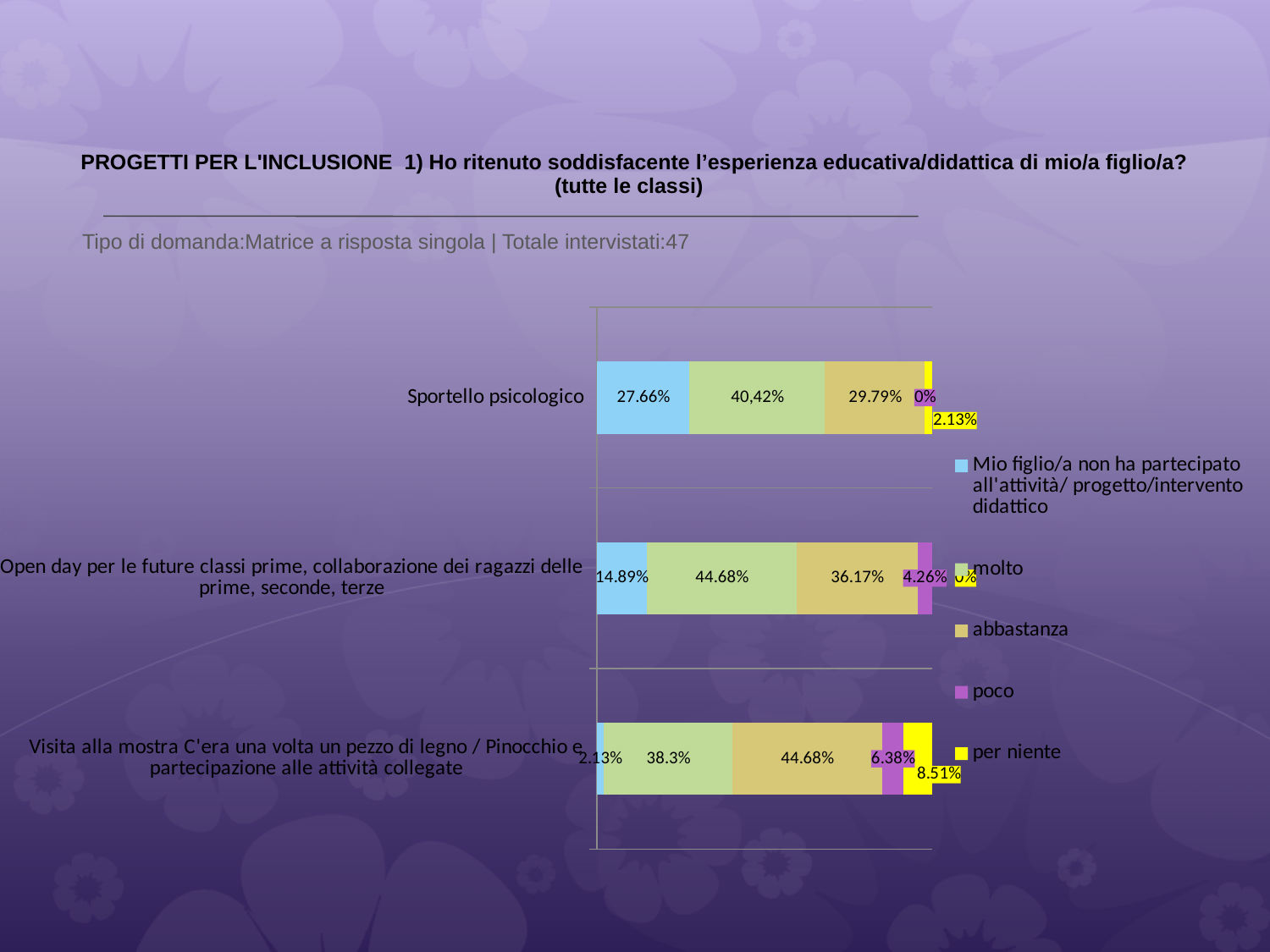
Which category has the lowest value for "Mio figlio/a non ha partecipato all'attività/ progetto/intervento didattico"? Visita alla mostra C'era una volta un pezzo di legno / Pinocchio e partecipazione alle attività collegate What kind of chart is shown on the slide? Stacked horizontal bar chart What is the total of all segments in the Sportello psicologico bar? 100% Which has a larger "molto" value: Open day per le future classi prime or Visita alla mostra / Pinocchio? Open day per le future classi prime, collaborazione dei ragazzi delle prime, seconde, terze How many categories (activities) are shown in the chart? 3 How many series does the legend list? 5 What is the "per niente" value for the Visita alla mostra / Pinocchio category? 8.51% What percentage of parents said their child did not participate ("Mio figlio/a non ha partecipato") in the Open day per le future classi prime activity? 14.89% Which category has the highest "abbastanza" value? Visita alla mostra C'era una volta un pezzo di legno / Pinocchio e partecipazione alle attività collegate What is the "abbastanza" value for the Visita alla mostra C'era una volta un pezzo di legno / Pinocchio category? 44.68% What is the difference between the "abbastanza" values for Open day per le future classi prime (36.17%) and Sportello psicologico (29.79%)? 6.38 percentage points What percentage of respondents answered "molto" for Sportello psicologico? 40,42%